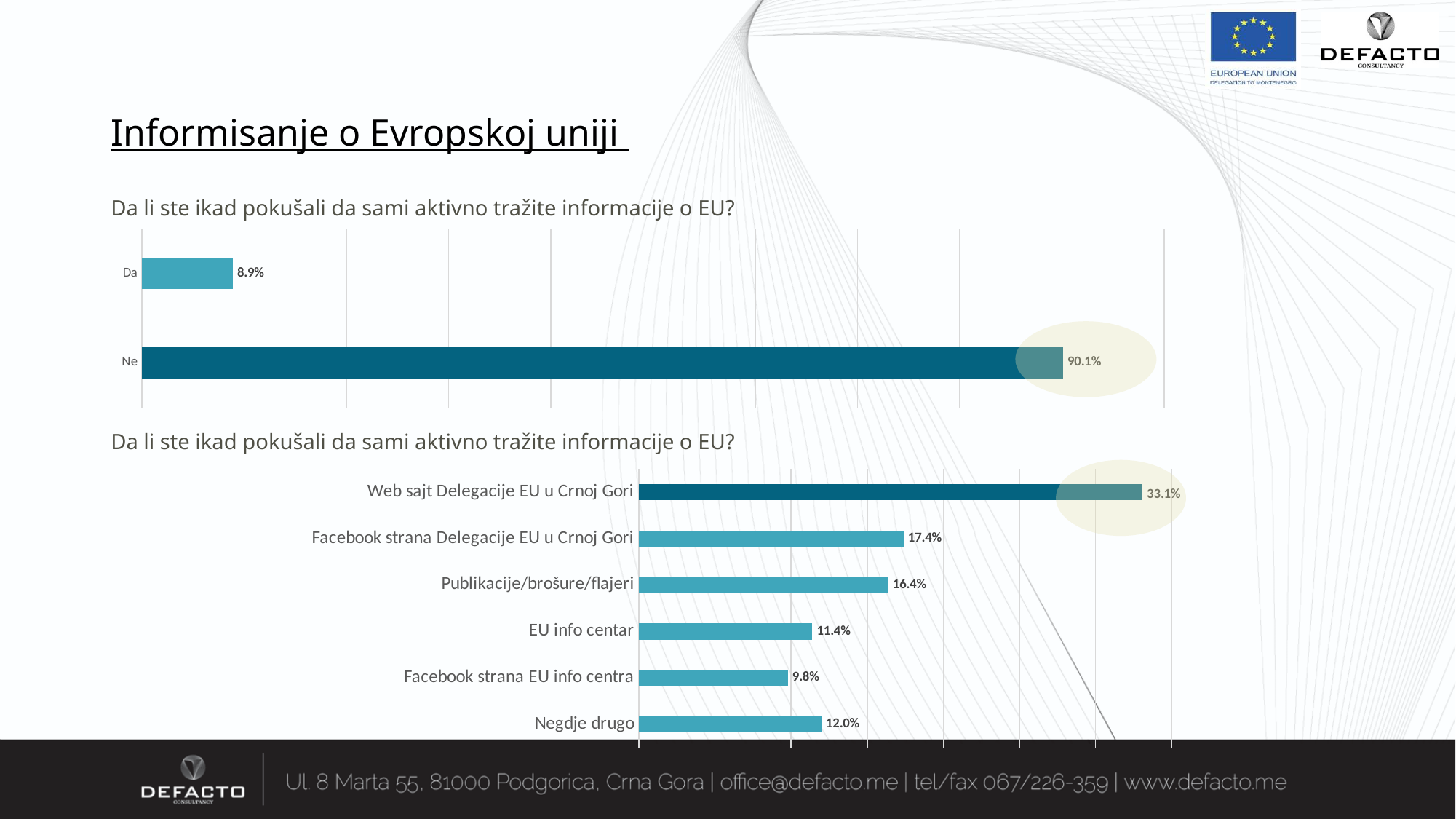
In the bottom chart, what is the value for "Negdje drugo"? 12.0% In the top chart, what is the difference between the values for "Ne" and "Da"? 81.2% What type of chart is the top chart? Bar chart In the bottom chart, what is the value for "EU info centar"? 11.4% In the bottom chart, which is larger: the value for "Facebook strana Delegacije EU u Crnoj Gori" or the value for "Publikacije/brošure/flajeri"? Facebook strana Delegacije EU u Crnoj Gori In the bottom chart, which category has the lowest value? Facebook strana EU info centra How many categories are shown in the bottom chart? 6 In the top chart, what is the value for "Ne"? 90.1% In the bottom chart, which category has the highest value? Web sajt Delegacije EU u Crnoj Gori In the top chart, what is the value for "Da"? 8.9% In the bottom chart, what is the difference between the values for "Web sajt Delegacije EU u Crnoj Gori" and "Facebook strana Delegacije EU u Crnoj Gori"? 15.7% In the bottom chart, what is the value for "Web sajt Delegacije EU u Crnoj Gori"? 33.1%